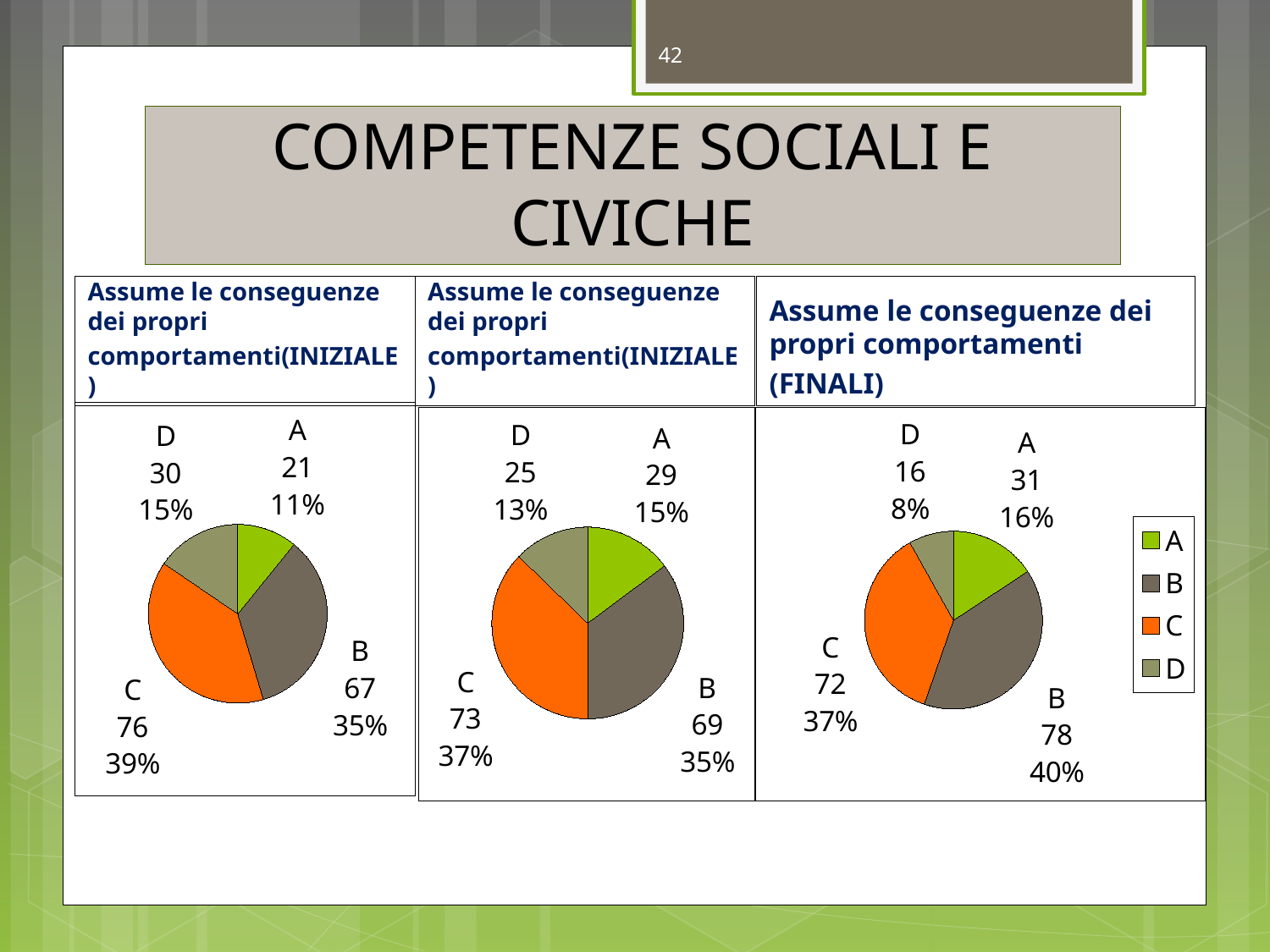
In the right pie chart (FINALI), which category has the largest slice? B In the left pie chart, which category has the smallest slice? A What type of chart is used on this slide? Pie chart In the right pie chart (FINALI), which is larger, the value for B or the value for C? B In the middle pie chart, what percentage share does category D have? 13% In the right pie chart (FINALI), what percentage share does category B have? 40% How many categories does the legend on the right list? 4 In the middle pie chart, what is the value for category B? 69 In the left pie chart, what percentage share does category A have? 11% In the middle pie chart, what is the difference between the values for C and A? 44 In the right pie chart (FINALI), what is the value for category D? 16 In the left pie chart, what is the value for category C? 76